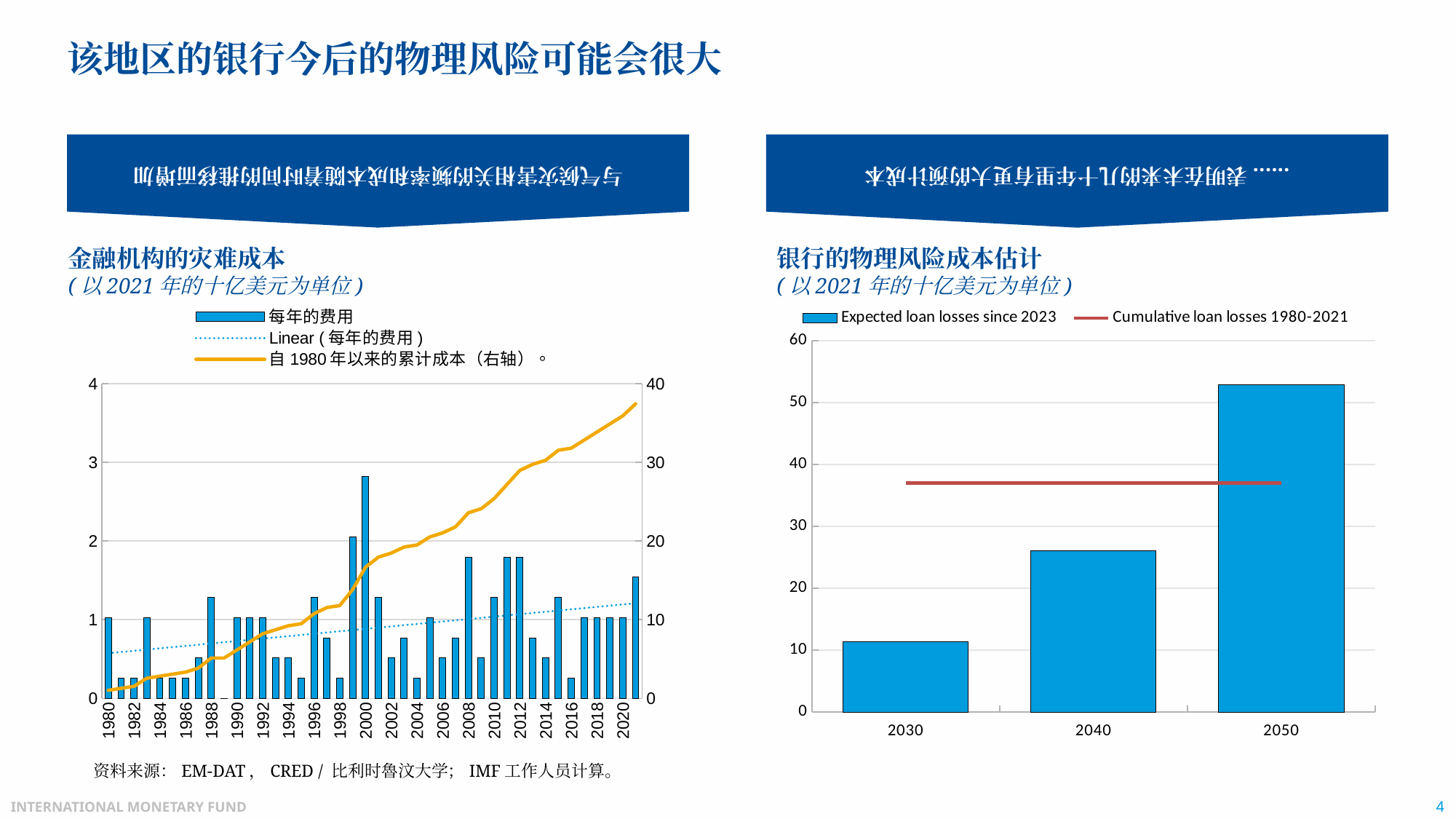
In the chart titled 银行的物理风险成本估计, which year has the highest expected loan losses? 2050 In the chart titled 金融机构的灾难成本, which year has the highest annual cost bar? 2000 In the chart titled 银行的物理风险成本估计, do the expected loan losses rise or fall from 2030 to 2050? rise In the chart titled 银行的物理风险成本估计, how many entries does the legend list? 2 In the chart titled 银行的物理风险成本估计, what does the red line represent? Cumulative loan losses 1980-2021 In the chart titled 银行的物理风险成本估计, is the value for 2050 greater or less than 50? greater In the chart titled 银行的物理风险成本估计, which year has the lowest expected loan losses? 2030 In the chart titled 银行的物理风险成本估计, is the value for 2040 greater or less than 30? less What kind of chart is the chart titled 银行的物理风险成本估计? combination bar and line chart In the chart titled 银行的物理风险成本估计, is the value for 2030 greater or less than 20? less In the chart titled 银行的物理风险成本估计, how many years are shown on the x axis? 3 In the chart titled 金融机构的灾难成本, does the cumulative cost line (right axis) rise or fall from 1980 to 2020? rise